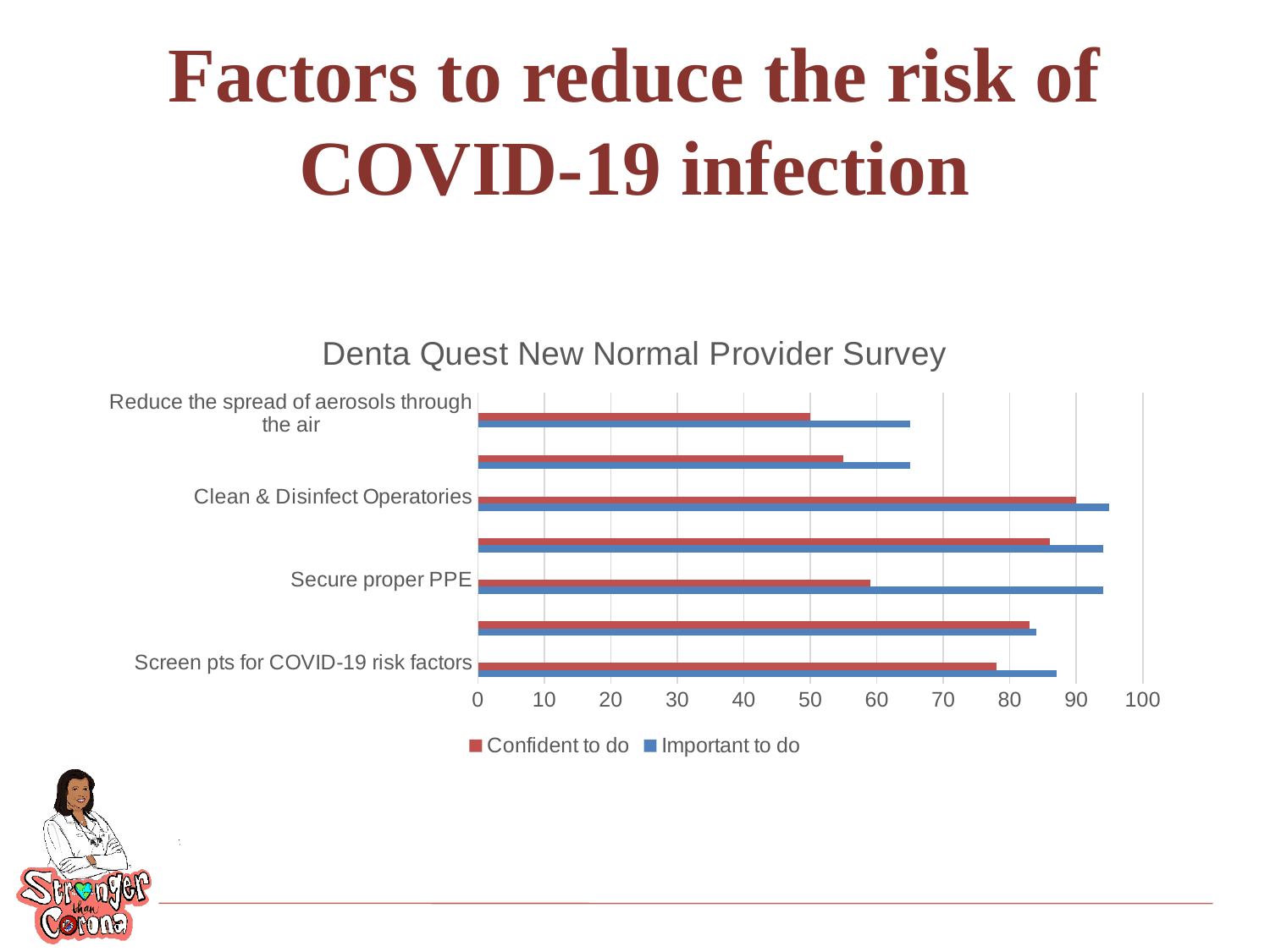
Is the 'Important to do' value for Screen pts for COVID-19 risk factors greater or less than 80? greater Which series is shown in blue in the chart? Important to do Is the 'Important to do' value for Secure proper PPE greater or less than 90? greater Which has the larger 'Confident to do' value: Clean & Disinfect Operatories or Reduce the spread of aerosols through the air? Clean & Disinfect Operatories Is the 'Confident to do' value for Clean & Disinfect Operatories greater or less than 80? greater What kind of chart is shown on the slide? bar chart For Secure proper PPE, which is larger: the 'Confident to do' value or the 'Important to do' value? Important to do What is the title of the chart? Denta Quest New Normal Provider Survey How many series does the chart's legend list? 2 Among the labelled categories, which has the lowest 'Confident to do' value? Reduce the spread of aerosols through the air